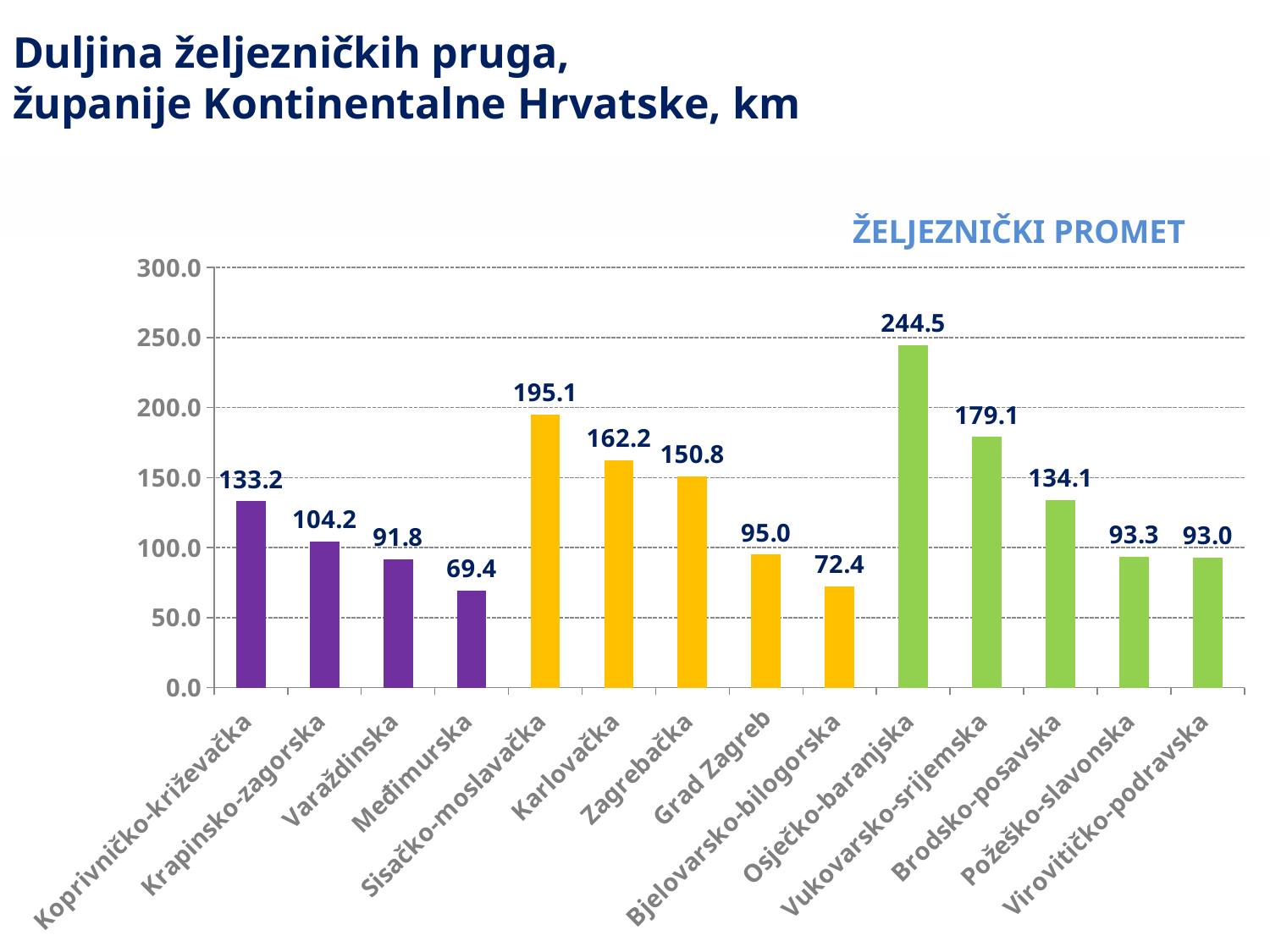
Which county has the lowest value? Međimurska What value is shown for Sisačko-moslavačka? 195.1 What is the difference between the values for Karlovačka and Zagrebačka? 11.4 What kind of chart is shown? bar chart What is the difference between the values for Osječko-baranjska and Vukovarsko-srijemska? 65.4 What colour are the bars for Sisačko-moslavačka, Karlovačka, Zagrebačka, Grad Zagreb and Bjelovarsko-bilogorska? yellow What is the length of railway lines for Osječko-baranjska? 244.5 What value is shown for Međimurska? 69.4 How many counties are shown on the chart? 14 Which county has the highest value? Osječko-baranjska Is the value for Grad Zagreb greater or less than 100.0? less Which is larger, the value for Koprivničko-križevačka or Brodsko-posavska? Brodsko-posavska